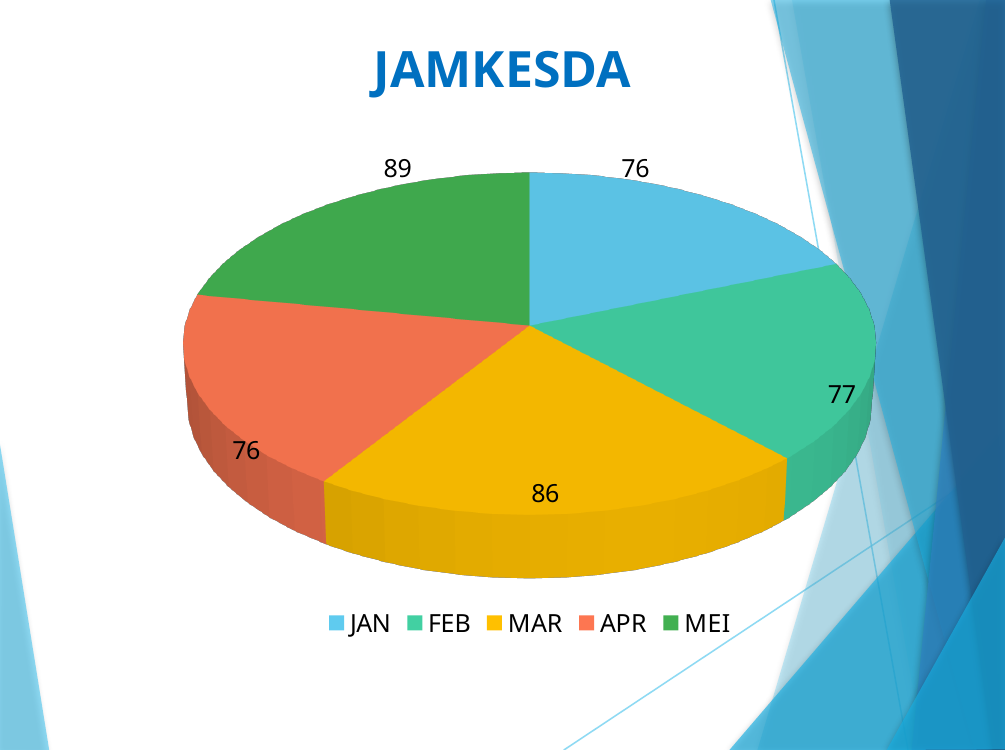
What is the value of the JAN slice? 76 What is the value of the MAR slice? 86 Which category has the largest slice? MEI What is the difference between the MEI and MAR values? 3 Which is larger, the MAR slice or the FEB slice? MAR What is the value of the FEB slice? 77 What is the difference between the MAR and FEB values? 9 What type of chart is shown on the slide? Pie chart What is the value of the MEI slice? 89 Which two categories share the smallest value? JAN and APR How many slices does the pie chart have? 5 What is the title of the chart? JAMKESDA